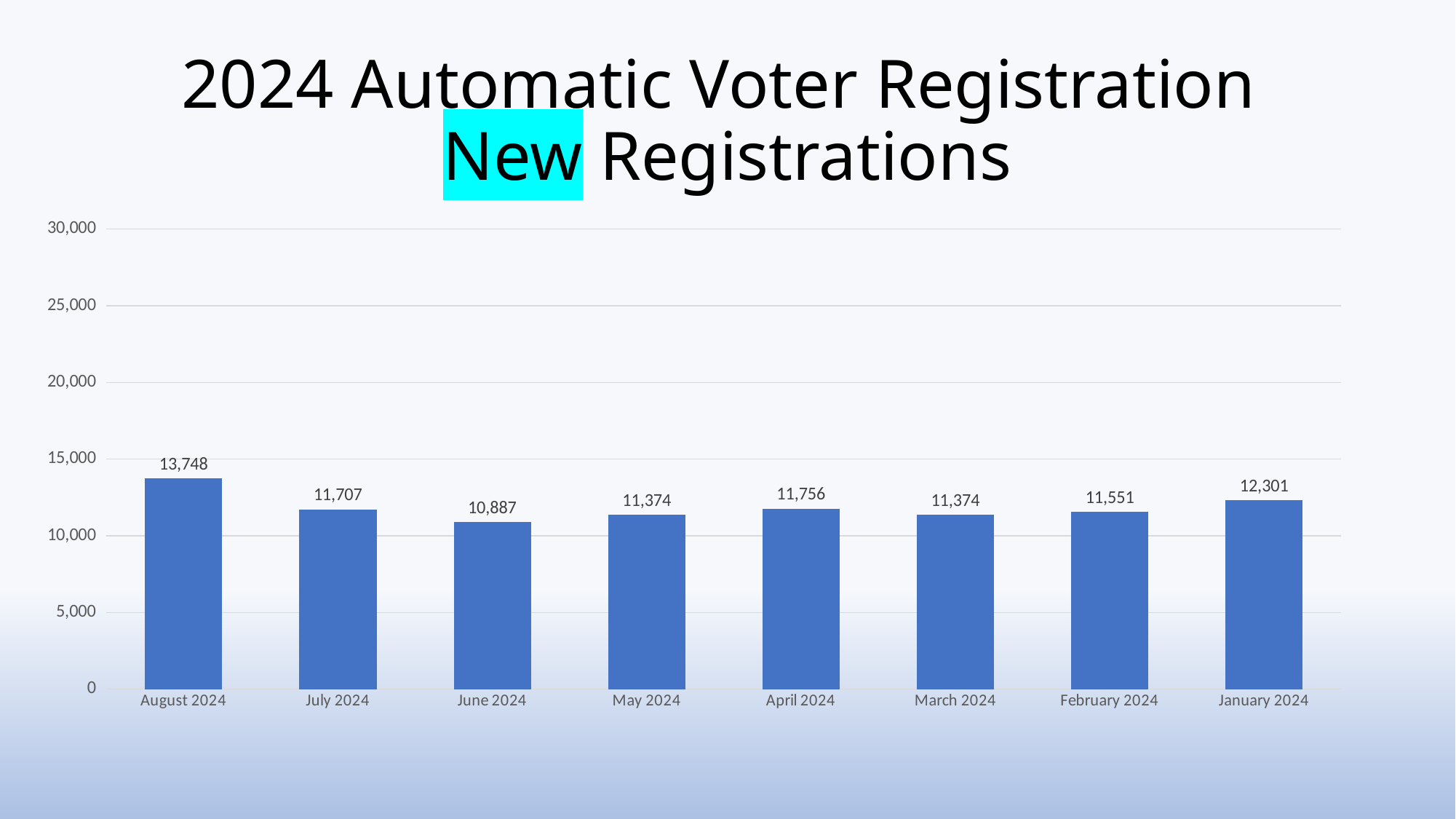
What is the difference between the values for August 2024 and June 2024? 2,861 What kind of chart is shown on the slide? bar chart What is the difference between the values for January 2024 and July 2024? 594 Which month has the highest number of new registrations? August 2024 What is the value for January 2024? 12,301 What is the title of the slide? 2024 Automatic Voter Registration New Registrations Is the value for August 2024 greater or less than 15,000? less Which is larger, the value for April 2024 or the value for February 2024? April 2024 How many months are shown on the chart? 8 What is the value for June 2024? 10,887 What is the value for August 2024? 13,748 Which month has the lowest number of new registrations? June 2024